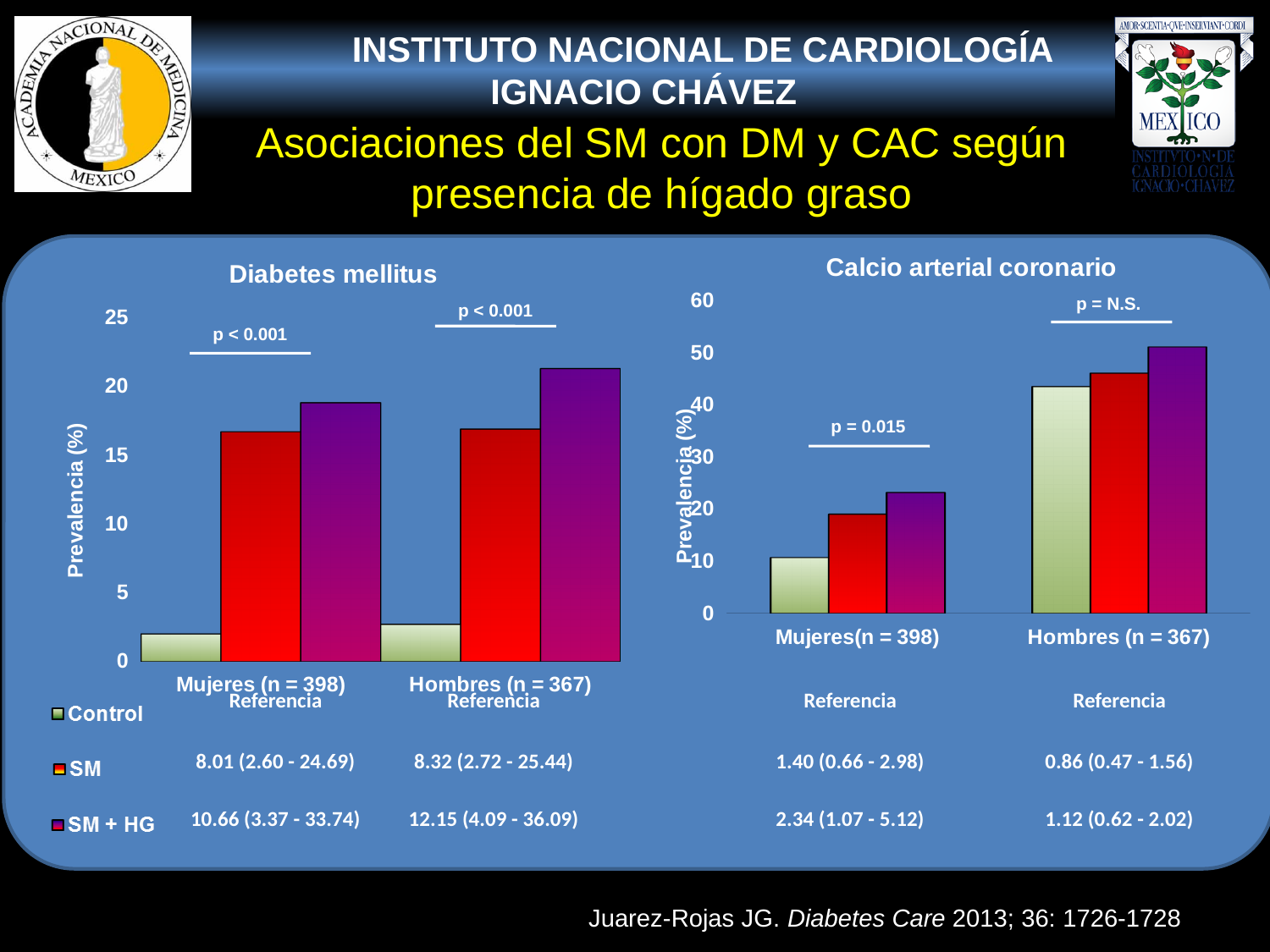
In the 'Calcio arterial coronario' chart, which is larger for Hombres (n = 367): the Control bar or the SM + HG bar? SM + HG How many series does the legend list for the 'Diabetes mellitus' chart? 3 What p-value is shown above the Mujeres (n = 398) bars in the 'Calcio arterial coronario' chart? p = 0.015 How many categories are shown on the x axis of the 'Calcio arterial coronario' chart? 2 In the 'Diabetes mellitus' chart, is the SM + HG value for Hombres (n = 367) greater or less than 20? greater In the 'Calcio arterial coronario' chart, is the SM + HG value for Mujeres (n = 398) greater or less than 30? less In the 'Diabetes mellitus' chart, which series has the tallest bar for Hombres (n = 367)? SM + HG In the 'Diabetes mellitus' chart, which series has the shortest bar for Mujeres (n = 398)? Control In the 'Calcio arterial coronario' chart, is the Control value for Hombres (n = 367) greater or less than 40? greater In the 'Calcio arterial coronario' chart, which series has the shortest bar for Mujeres (n = 398)? Control What kind of chart is the 'Diabetes mellitus' chart? bar chart